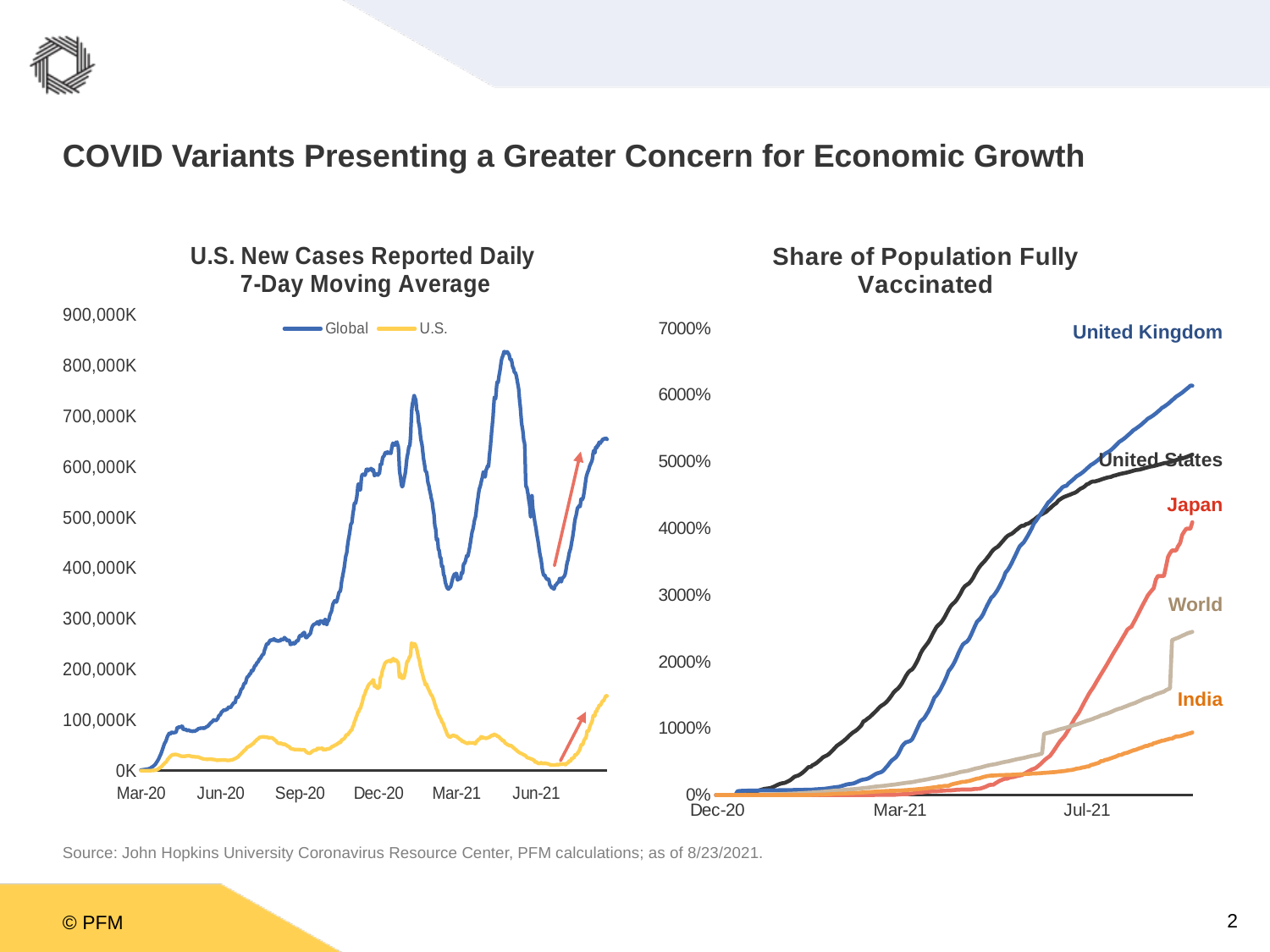
In the 'U.S. New Cases Reported Daily 7-Day Moving Average' chart, what are the two legend entries? Global and U.S. In the 'Share of Population Fully Vaccinated' chart, is the final value for World greater or less than 3000%? less In the 'Share of Population Fully Vaccinated' chart, do the lines generally rise or fall from Dec-20 to Jul-21? Rise How many countries or regions are plotted in the 'Share of Population Fully Vaccinated' chart? 5 How many series does the legend of the 'U.S. New Cases Reported Daily 7-Day Moving Average' chart list? 2 In the 'Share of Population Fully Vaccinated' chart, which line is lowest at the end of the period? India In the 'Share of Population Fully Vaccinated' chart, which line is highest at the end of the period? United Kingdom In the 'U.S. New Cases Reported Daily 7-Day Moving Average' chart, is the peak value of the Global series greater or less than 700,000K? greater In the 'U.S. New Cases Reported Daily 7-Day Moving Average' chart, which series reaches higher values, Global or U.S.? Global In the 'U.S. New Cases Reported Daily 7-Day Moving Average' chart, is the peak value of the U.S. series greater or less than 300,000K? less What kind of chart is the 'U.S. New Cases Reported Daily 7-Day Moving Average' chart? Line chart What kind of chart is the 'Share of Population Fully Vaccinated' chart? Line chart